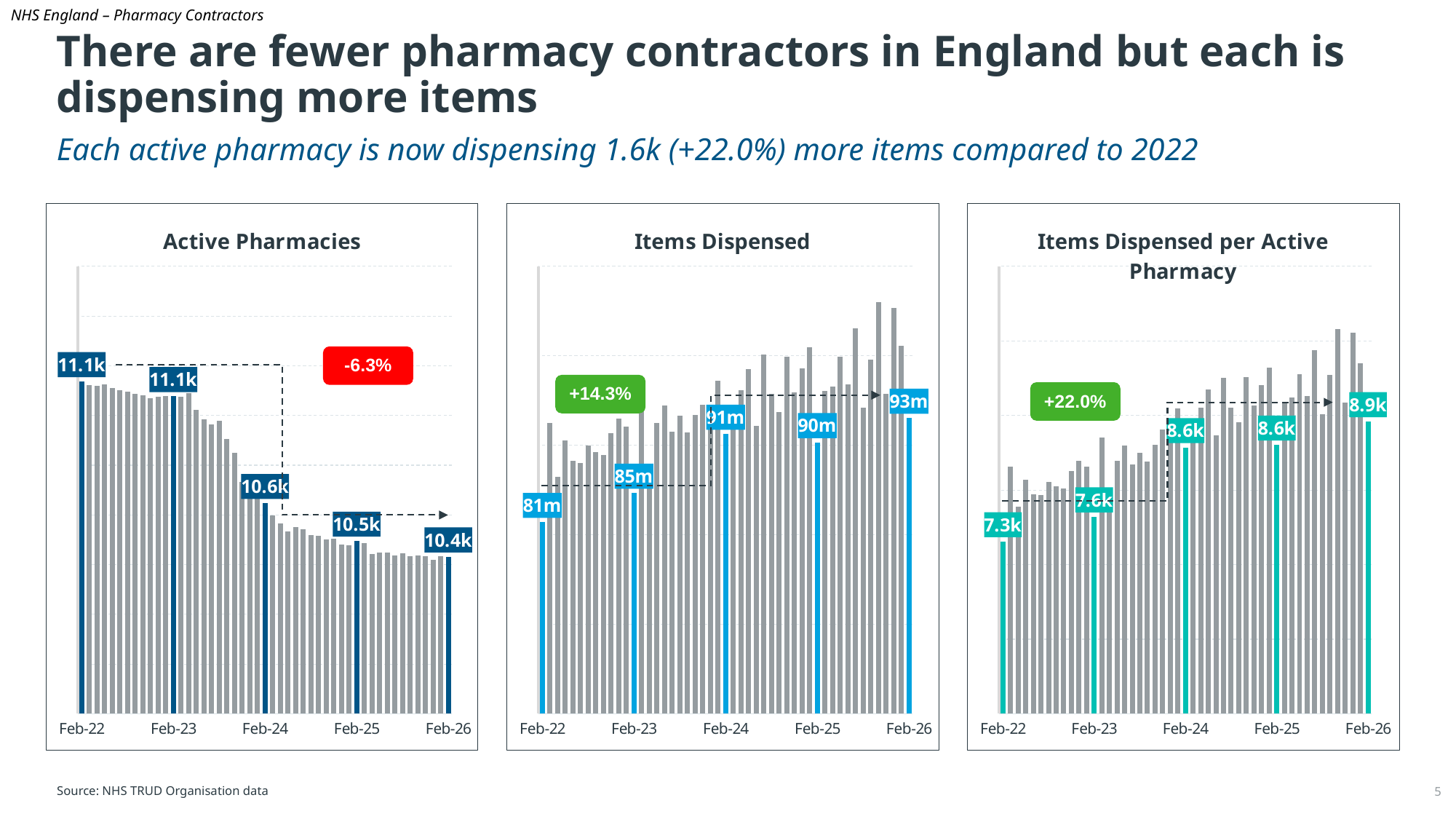
In the Items Dispensed chart, which labelled value is larger, Feb-24 or Feb-25? Feb-24 In the Active Pharmacies chart, do the values generally rise or fall from Feb-22 to Feb-26? fall In the Active Pharmacies chart, what is the value labelled for Feb-26? 10.4k In the Items Dispensed chart, what is the difference between the labelled values for Feb-26 and Feb-22? 12m In the Items Dispensed chart, which of the labelled February values is the highest? Feb-26 In the Items Dispensed chart, what is the value labelled for Feb-23? 85m What kind of chart is the Items Dispensed per Active Pharmacy chart? bar chart In the Active Pharmacies chart, what is the value labelled for Feb-22? 11.1k In the Items Dispensed per Active Pharmacy chart, what is the value labelled for Feb-24? 8.6k In the Active Pharmacies chart, what is the difference between the labelled values for Feb-22 and Feb-26? 0.7k In the Items Dispensed per Active Pharmacy chart, which of the labelled February values is the lowest? Feb-22 What percentage change is shown in the callout on the Active Pharmacies chart? -6.3%